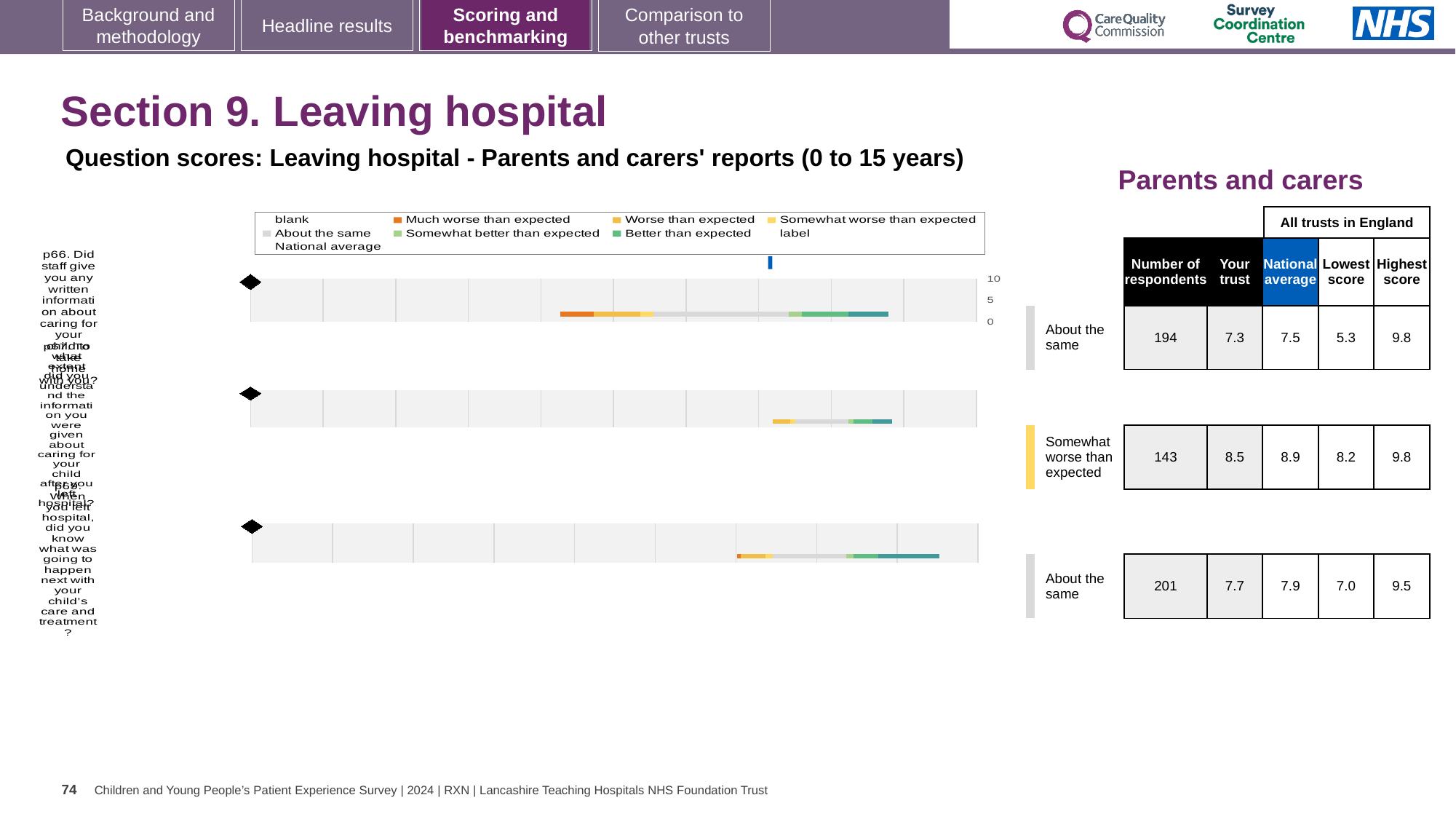
In the table, what is the lowest score for the top chart (first row)? 5.3 What kind of chart is used to show the question scores on this slide? bar chart Is the 'Your trust' score in the first row of the table larger or smaller than the national average in that row? smaller Which row of the table has the fewest respondents? the second row (143) In the table, what is the national average for the middle chart (second row)? 8.9 Which row of the table has the highest 'Your trust' score? the second row (8.5) In the table, how many respondents are listed for the bottom chart (third row)? 201 What is the difference between the national average and the 'Your trust' score in the second row of the table? 0.4 How many question score charts are shown on the slide? 3 In the table, what is the 'Your trust' score for the top chart (first row)? 7.3 What benchmark category is shown next to the middle chart (second row)? Somewhat worse than expected In the table, what is the highest score for the bottom chart (third row)? 9.5